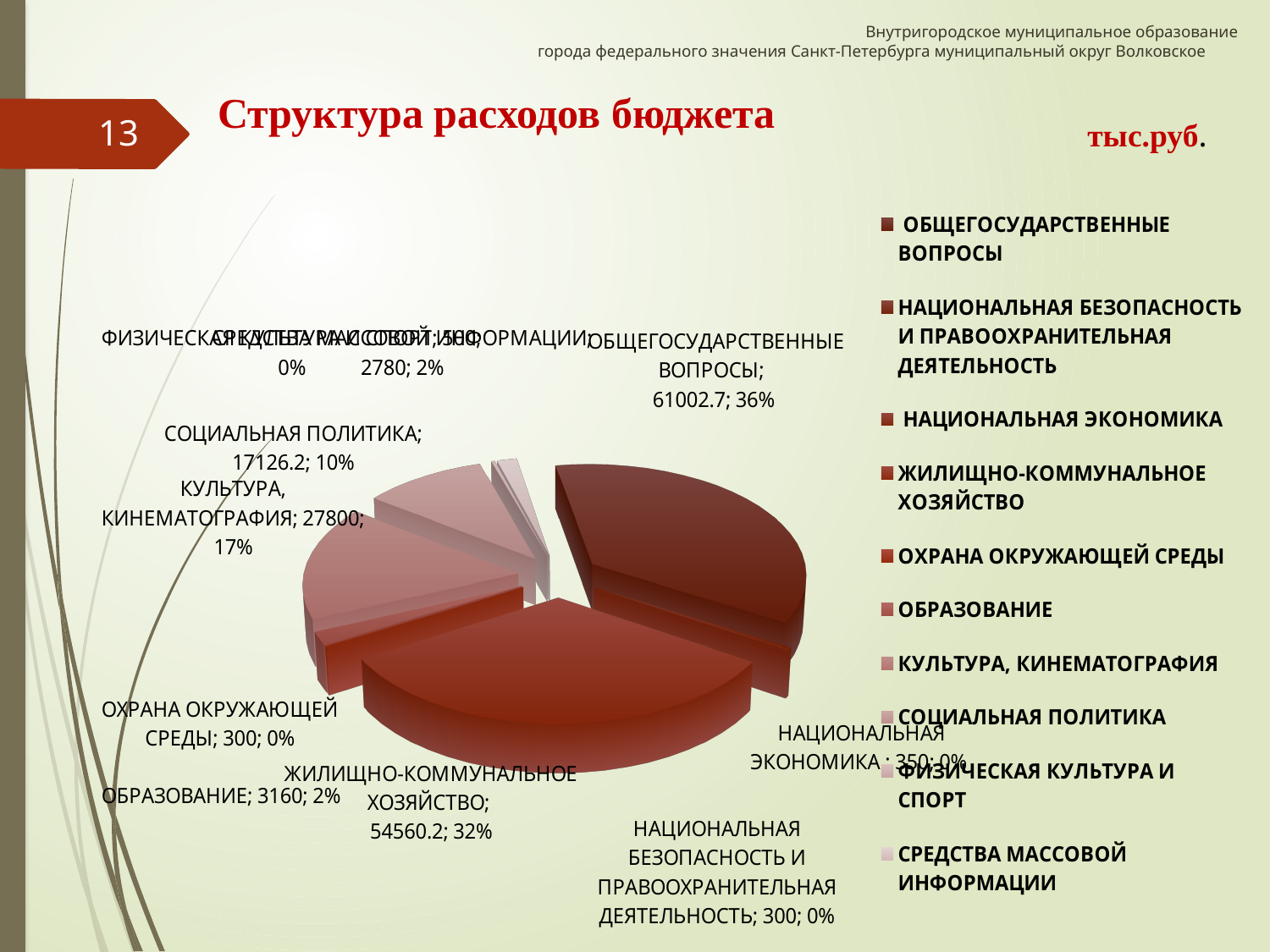
What share of the pie does ЖИЛИЩНО-КОММУНАЛЬНОЕ ХОЗЯЙСТВО represent? 32% Which category has the largest share of the pie? ОБЩЕГОСУДАРСТВЕННЫЕ ВОПРОСЫ Which is larger, the value for КУЛЬТУРА, КИНЕМАТОГРАФИЯ or the value for СОЦИАЛЬНАЯ ПОЛИТИКА? КУЛЬТУРА, КИНЕМАТОГРАФИЯ What is the value for СОЦИАЛЬНАЯ ПОЛИТИКА? 17126.2 What is the value for ЖИЛИЩНО-КОММУНАЛЬНОЕ ХОЗЯЙСТВО? 54560.2 What share of the pie does КУЛЬТУРА, КИНЕМАТОГРАФИЯ represent? 17% What is the value for ОБЩЕГОСУДАРСТВЕННЫЕ ВОПРОСЫ? 61002.7 How many categories does the legend list? 10 What is the title of the chart? Структура расходов бюджета What is the difference between the values for ОБЩЕГОСУДАРСТВЕННЫЕ ВОПРОСЫ and ЖИЛИЩНО-КОММУНАЛЬНОЕ ХОЗЯЙСТВО? 6442.5 What kind of chart is shown on the slide? pie chart What is the value for ОБРАЗОВАНИЕ? 3160